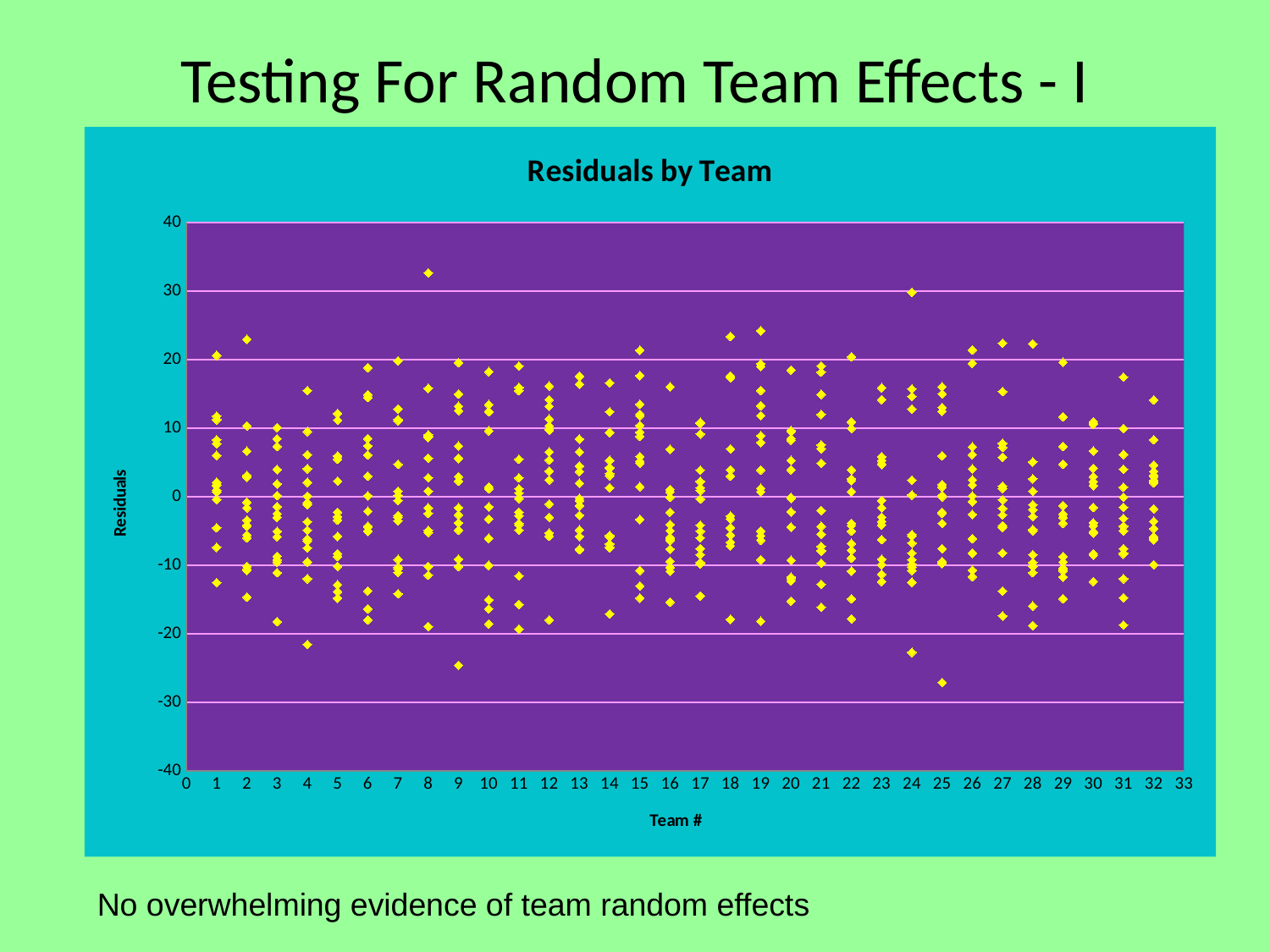
Is the highest residual for team 8 greater or less than 30? greater How many teams have residuals plotted on the chart? 32 Is the highest residual for team 19 greater or less than 20? greater What kind of chart is shown on the slide? Scatter plot Is the lowest residual for team 4 greater or less than -20? less Which is larger, the highest residual for team 8 or the highest residual for team 2? Team 8 What is the label of the horizontal axis of the chart? Team # What is the title of the chart? Residuals by Team Which team has the single highest residual on the chart? Team 8